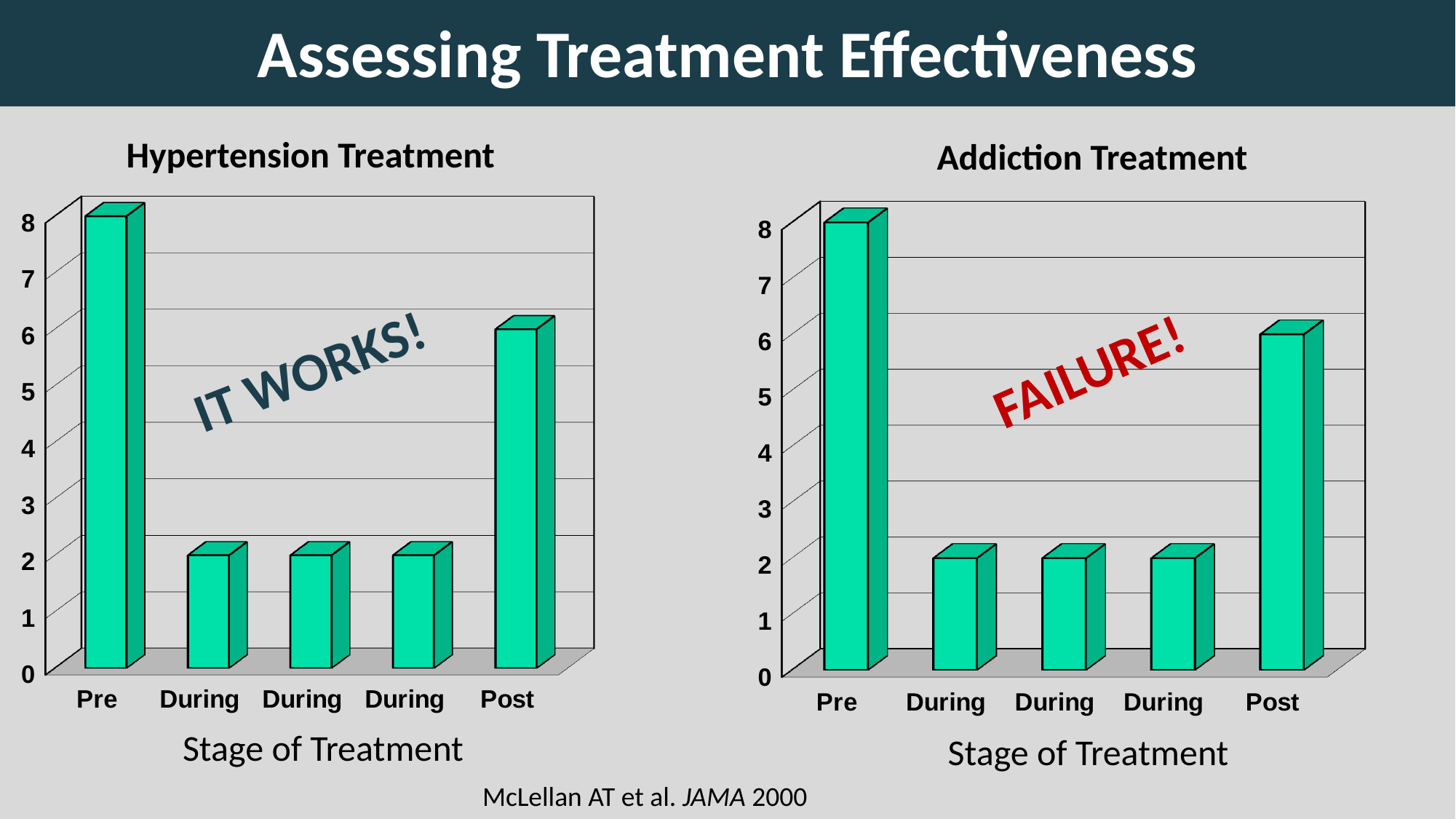
In the Hypertension Treatment chart, what is the value for each During stage? 2 In the Hypertension Treatment chart, what is the difference between the Pre and Post values? 2 In the Addiction Treatment chart, what is the difference between the Pre value and a During value? 6 In the Hypertension Treatment chart, what is the value for the Pre stage? 8 What is the x-axis title of the Hypertension Treatment chart? Stage of Treatment In the Addiction Treatment chart, which stage has the highest value? Pre In the Hypertension Treatment chart, which is larger, the Pre value or the Post value? Pre In the Addiction Treatment chart, what is the value for the Post stage? 6 What kind of chart is the Addiction Treatment chart? bar chart In the Addiction Treatment chart, is the value for Post greater or less than 4? greater What word is written in red across the Addiction Treatment chart? FAILURE! How many bars are shown in the Hypertension Treatment chart? 5